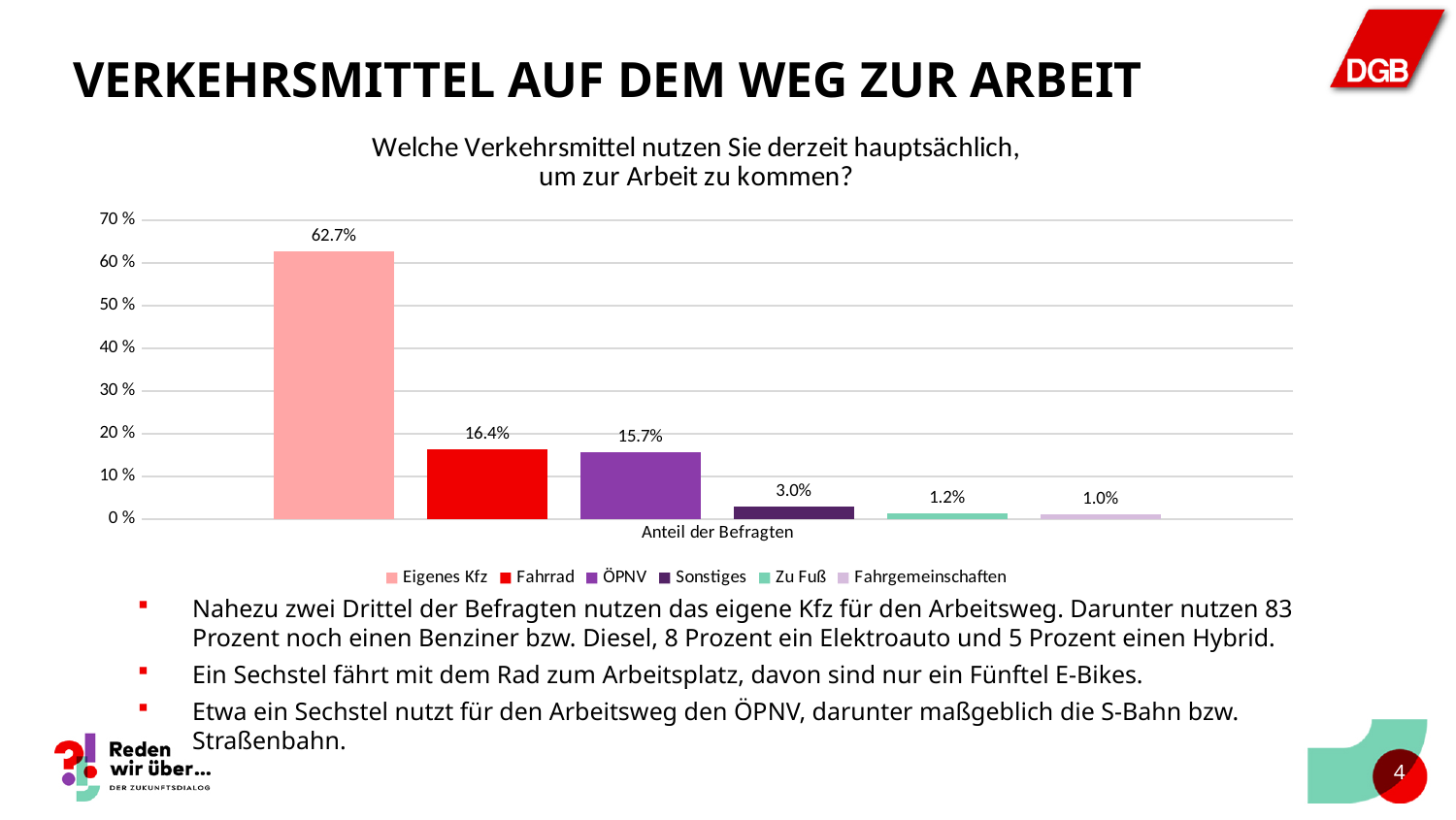
What is the difference between the values for Sonstiges and Zu Fuß? 1.8% What is the value shown for Eigenes Kfz? 62.7% Which is larger, the value for Fahrrad or the value for Sonstiges? Fahrrad Which mode of transport has the highest share? Eigenes Kfz What kind of chart is shown on the slide? Bar chart What is the difference between the values for Eigenes Kfz and Fahrrad? 46.3% What is the value shown for Zu Fuß? 1.2% Which mode of transport has the lowest share? Fahrgemeinschaften What is the value shown for ÖPNV? 15.7% What is the label shown on the x axis of the chart? Anteil der Befragten What is the value shown for Fahrrad? 16.4% How many series does the legend list? 6